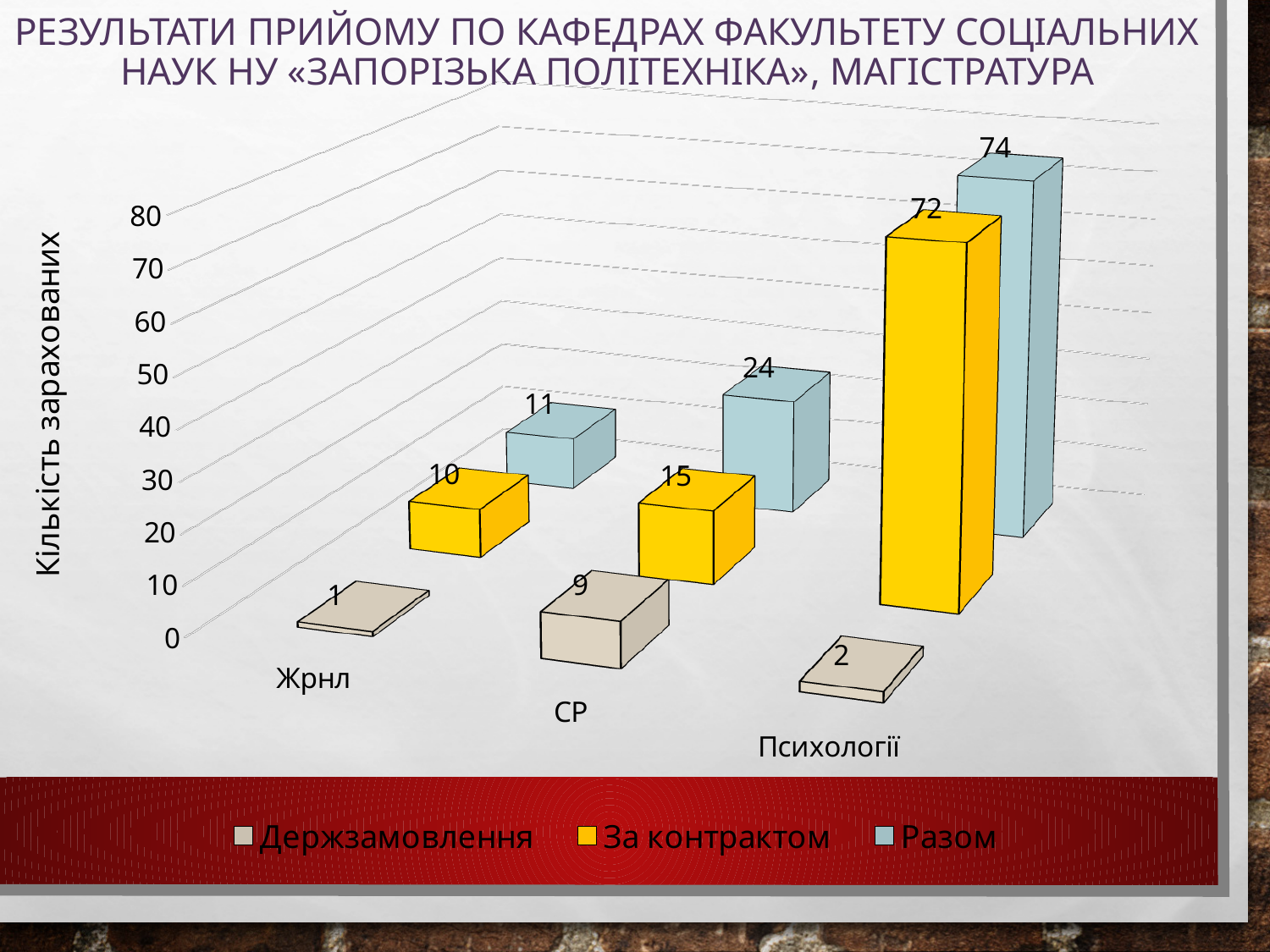
What is the value for Разом in the СР category? 24 What is the value for За контрактом in the Психології category? 72 What is the label of the vertical axis? Кількість зарахованих How many series does the legend list? 3 What kind of chart is shown on the slide? Bar chart Which category has the highest value for Разом? Психології What is the value for Держзамовлення in the СР category? 9 Which is larger: За контрактом for СР or За контрактом for Жрнл? За контрактом for СР Which category has the lowest value for Держзамовлення? Жрнл What is the value for Держзамовлення in the Жрнл category? 1 What is the difference between the Разом values for Психології and СР? 50 How many categories are shown on the x axis? 3